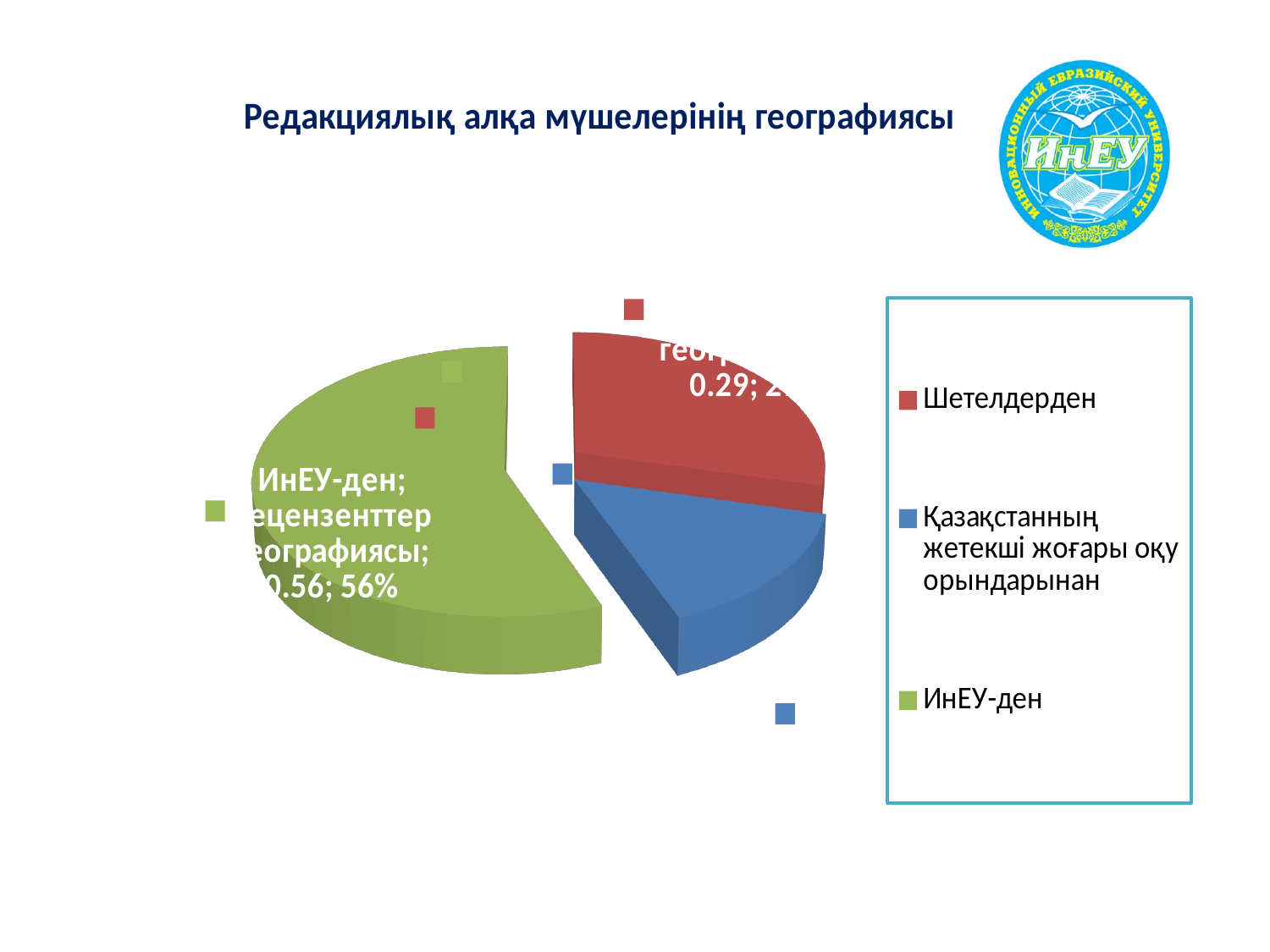
How many entries does the legend list? 3 How many slices does the pie chart have? 3 What is the title of the chart on the slide? Редакциялық алқа мүшелерінің географиясы What colour is used for the Шетелдерден slice? red What share of the pie does the ИнЕУ-ден slice represent? 56% Which slice is larger, ИнЕУ-ден or Шетелдерден? ИнЕУ-ден Is the share for ИнЕУ-ден greater or less than 50%? greater What value is printed on the Шетелдерден slice label before the percentage? 0.29 Which category has the smallest slice of the pie? Қазақстанның жетекші жоғары оқу орындарынан What value is printed on the ИнЕУ-ден slice label before the percentage? 0.56 What kind of chart is shown on the slide? pie chart Which category has the largest slice of the pie? ИнЕУ-ден